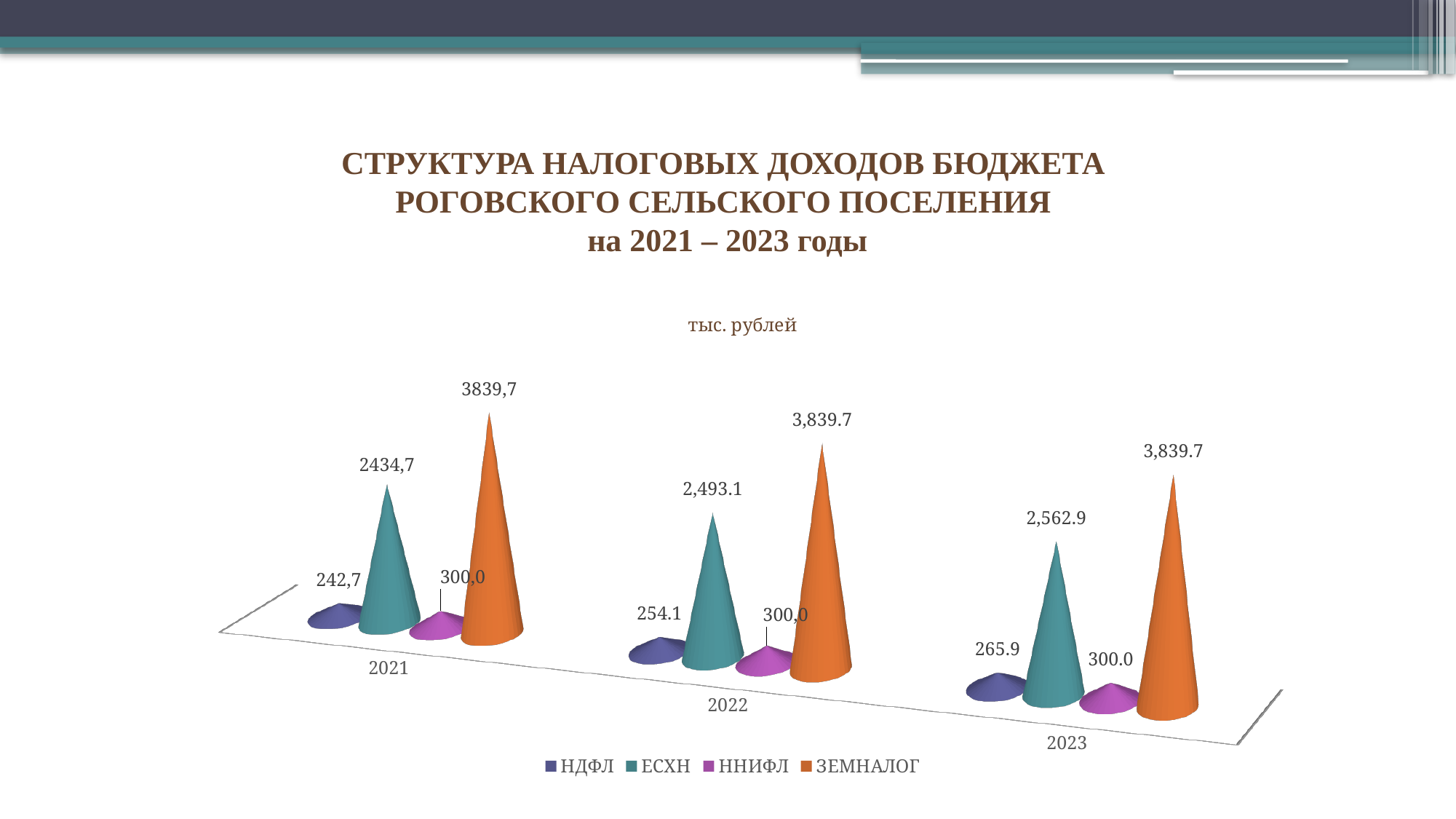
What is the value for ЕСХН in 2021? 2434,7 What is the value for ЗЕМНАЛОГ in 2022? 3,839.7 Which series has the highest value in 2022? ЗЕМНАЛОГ What is the value for НДФЛ in 2023? 265.9 How many years (categories) are shown on the x axis? 3 What is the value for ННИФЛ in 2023? 300.0 What is the difference between ЗЕМНАЛОГ and ЕСХН in 2023? 1,276.8 Which series has the lowest value in 2021? НДФЛ Does the value for ЕСХН rise or fall from 2021 to 2023? rise How many series does the legend list? 4 Which is larger in 2022: НДФЛ or ННИФЛ? ННИФЛ What unit is given in the chart title? тыс. рублей